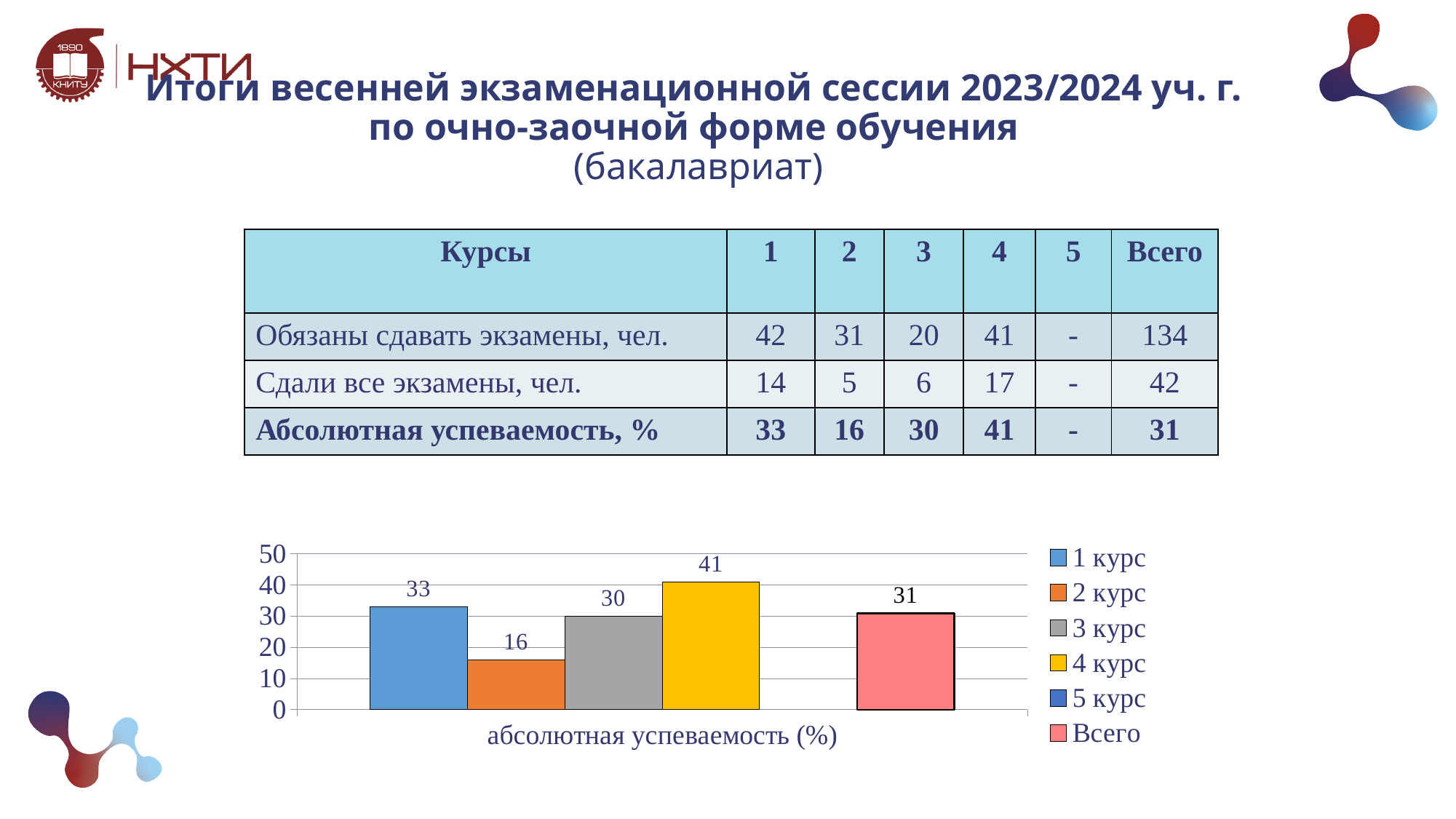
What colour is the bar for 4 курс in the chart? yellow Which series has the lowest value in the chart? 2 курс What type of chart is shown on the slide? bar chart How many series does the chart legend list? 6 Which series has the highest value in the chart? 4 курс What is the x-axis category label of the chart? абсолютная успеваемость (%) In the chart, what is the value for 2 курс? 16 Which is larger in the chart, the value for 1 курс or the value for 3 курс? 1 курс What is the difference between the values for 4 курс and 2 курс in the chart? 25 In the chart, what is the value for 1 курс? 33 In the chart, what is the value for 4 курс? 41 In the chart, what is the value for Всего? 31